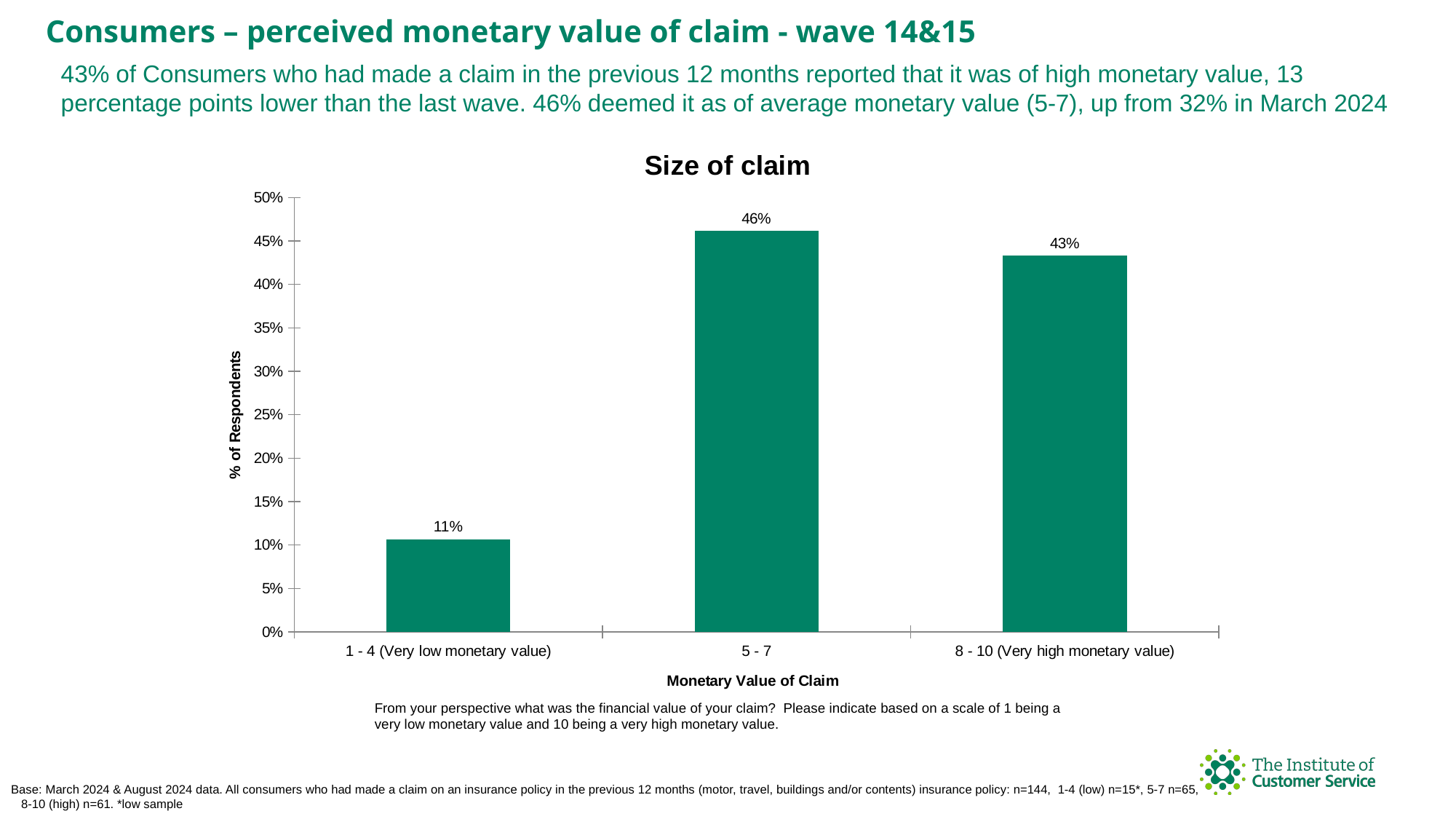
What is the label of the y axis of the chart? % of Respondents What percentage of respondents rated their claim as 1 - 4 (Very low monetary value)? 11% What percentage of respondents rated their claim as 5 - 7? 46% Which is larger: the value for 5 - 7 or the value for 8 - 10 (Very high monetary value)? 5 - 7 What percentage of respondents rated their claim as 8 - 10 (Very high monetary value)? 43% What type of chart is shown on the slide? Bar chart How many categories are shown on the x axis of the chart? 3 Which category has the lowest percentage of respondents? 1 - 4 (Very low monetary value) What is the difference in percentage points between the 8 - 10 (Very high monetary value) category and the 1 - 4 (Very low monetary value) category? 32 percentage points Which category has the highest percentage of respondents? 5 - 7 What is the difference in percentage points between the 5 - 7 category and the 1 - 4 (Very low monetary value) category? 35 percentage points What is the title of the chart? Size of claim